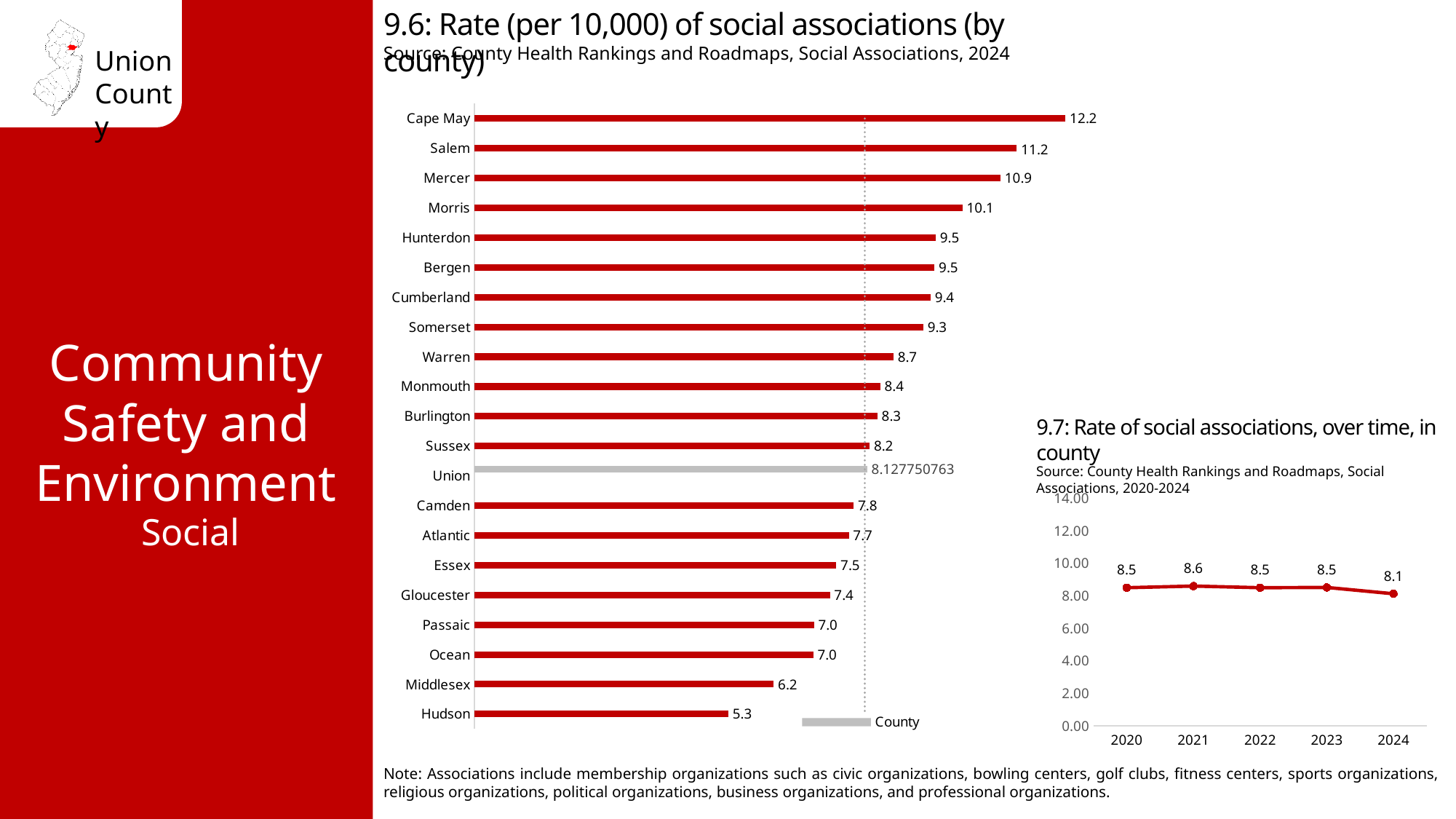
In the chart '9.6: Rate (per 10,000) of social associations (by county)', what is the value for Cape May? 12.2 What kind of chart is '9.6: Rate (per 10,000) of social associations (by county)'? Bar chart In the chart '9.6: Rate (per 10,000) of social associations (by county)', what is the difference between Salem and Middlesex? 5.0 How many counties are shown in the chart '9.6: Rate (per 10,000) of social associations (by county)'? 21 In the chart '9.6: Rate (per 10,000) of social associations (by county)', which county has the lowest rate? Hudson What kind of chart is '9.7: Rate of social associations, over time, in county'? Line chart In the chart '9.6: Rate (per 10,000) of social associations (by county)', which county has the highest rate? Cape May In the chart '9.7: Rate of social associations, over time, in county', which year has the highest value? 2021 In the chart '9.6: Rate (per 10,000) of social associations (by county)', what is the value shown for Union? 8.127750763 In the chart '9.7: Rate of social associations, over time, in county', what is the value for 2024? 8.1 In the chart '9.6: Rate (per 10,000) of social associations (by county)', which is larger, Mercer or Morris? Mercer How many years are plotted in the chart '9.7: Rate of social associations, over time, in county'? 5